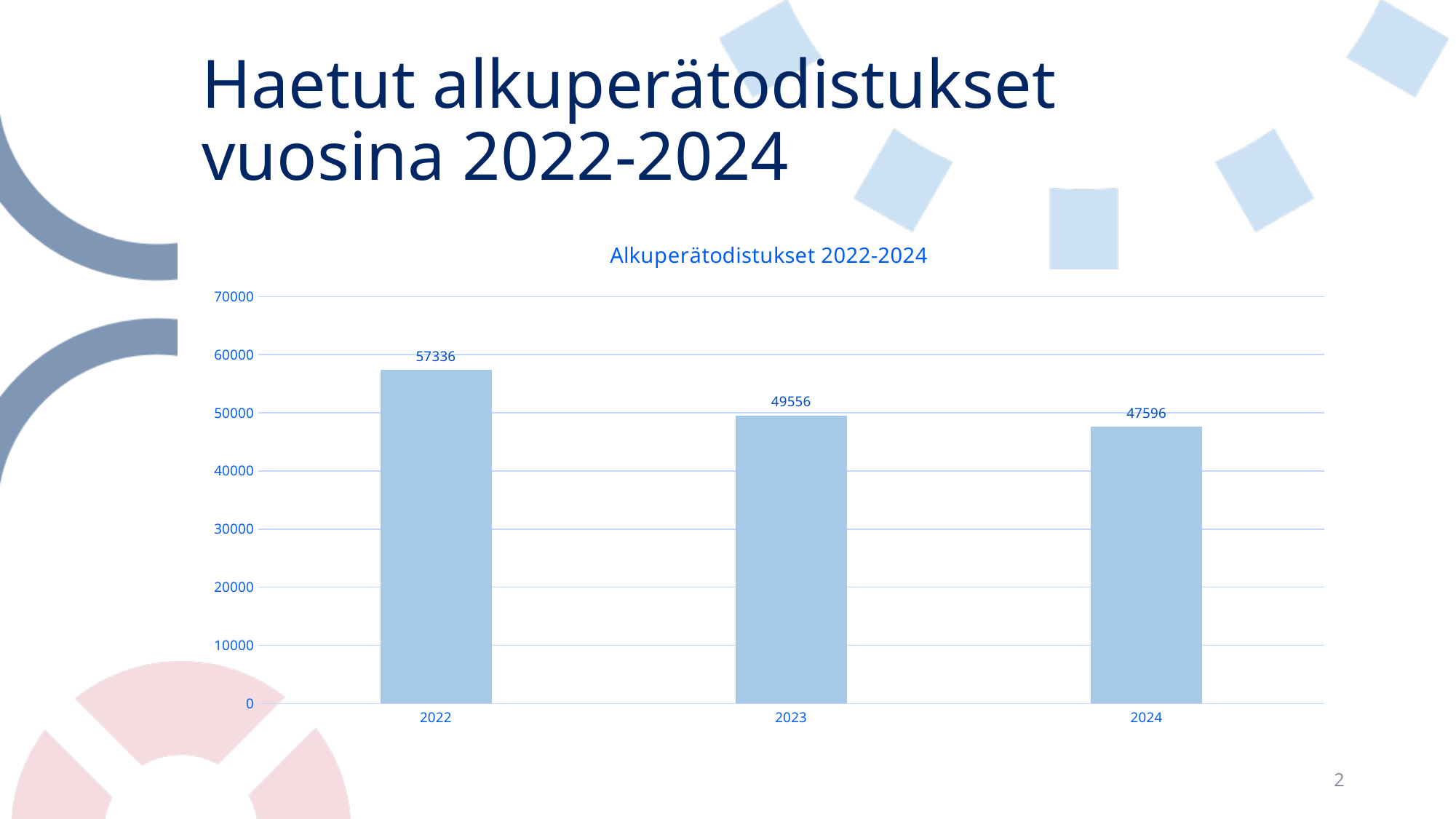
Which year has the highest value? 2022 How many years are shown on the x axis? 3 What kind of chart is shown on the slide? bar chart What is the difference between the values for 2023 and 2024? 1960 What is the value for 2022? 57336 Do the values rise or fall from 2022 to 2024? fall Is the value for 2024 greater or less than 50000? less Which year has the lowest value? 2024 What is the value for 2024? 47596 Which is larger, the value for 2022 or the value for 2023? 2022 What is the difference between the values for 2022 and 2024? 9740 What is the value for 2023? 49556